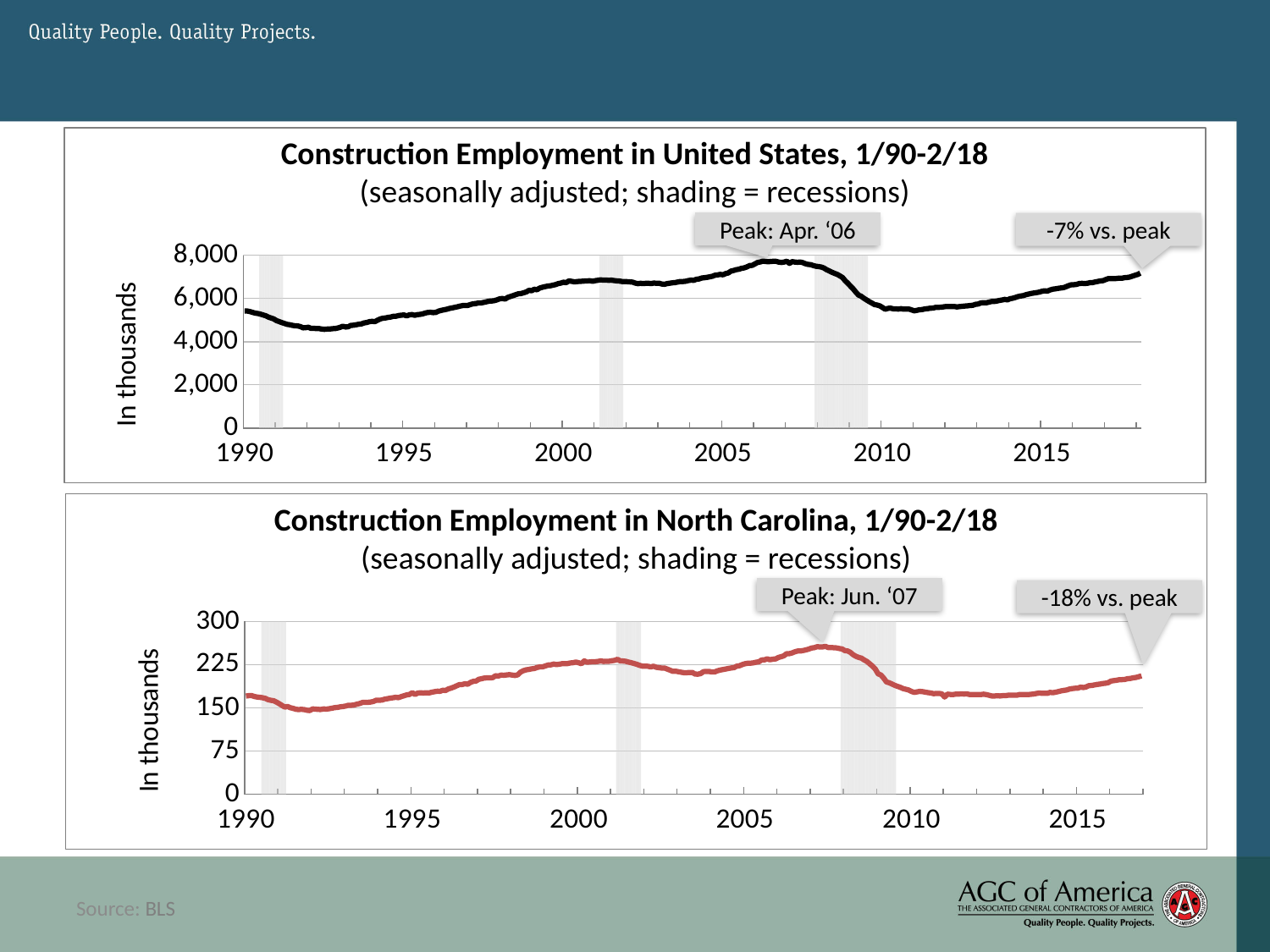
In the 'Construction Employment in United States' chart, is the value in 1990 greater or less than 6,000? less In the 'Construction Employment in North Carolina' chart, is the value at the 2007 peak greater or less than 225? greater In the 'Construction Employment in United States' chart, is the value at the 2006 peak greater or less than 6,000? greater In the 'Construction Employment in United States' chart, does the line rise or fall between 2010 and 2018? rise What kind of chart is the 'Construction Employment in North Carolina, 1/90-2/18' chart? line chart In the 'Construction Employment in North Carolina' chart, does the line rise or fall between 2007 and 2010? fall In the 'Construction Employment in United States' chart, when does the annotation say the peak occurred? Apr. '06 What kind of chart is the 'Construction Employment in United States, 1/90-2/18' chart? line chart In the 'Construction Employment in North Carolina' chart, how far below the peak is the latest value according to the annotation? -18% vs. peak